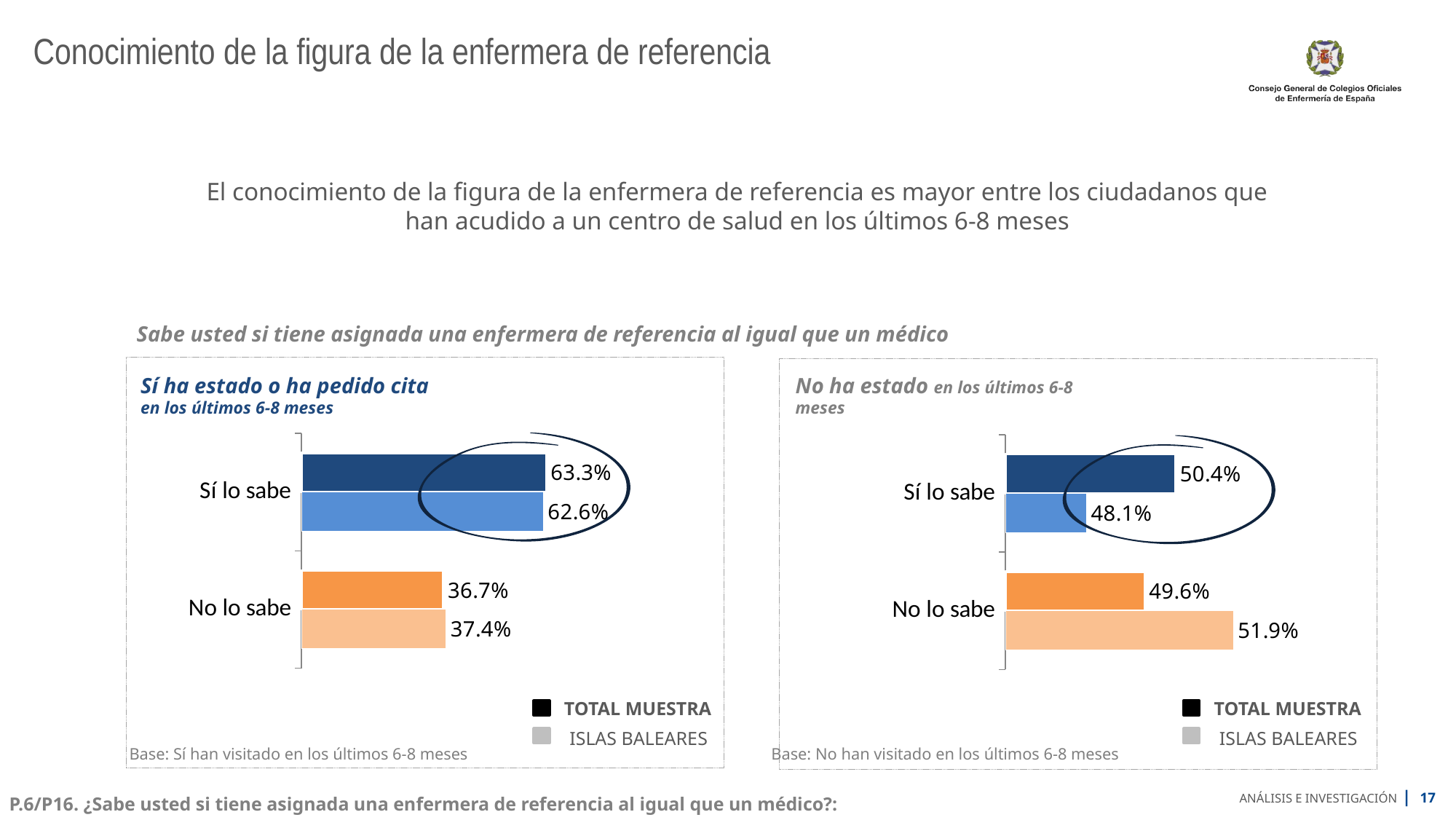
In the right chart (No ha estado), which is larger for ISLAS BALEARES: 'Sí lo sabe' or 'No lo sabe'? No lo sabe In the left chart (Sí ha estado o ha pedido cita), what is the ISLAS BALEARES value for 'No lo sabe'? 37.4% In the left chart (Sí ha estado o ha pedido cita), which category has the highest value across both series? Sí lo sabe (TOTAL MUESTRA) What are the two legend entries shown in the right chart (No ha estado)? TOTAL MUESTRA and ISLAS BALEARES In the left chart (Sí ha estado o ha pedido cita), what is the TOTAL MUESTRA value for 'Sí lo sabe'? 63.3% In the right chart (No ha estado), what is the ISLAS BALEARES value for 'Sí lo sabe'? 48.1% In the left chart (Sí ha estado o ha pedido cita), what is the difference between the TOTAL MUESTRA values for 'Sí lo sabe' and 'No lo sabe'? 26.6% How many series does the legend of the left chart list? 2 How many categories are shown in the right chart (No ha estado)? 2 What type of chart is used in the left panel (Sí ha estado o ha pedido cita)? Bar chart In the right chart (No ha estado), what is the TOTAL MUESTRA value for 'No lo sabe'? 49.6% In the right chart (No ha estado), what is the difference between the ISLAS BALEARES values for 'No lo sabe' and 'Sí lo sabe'? 3.8%